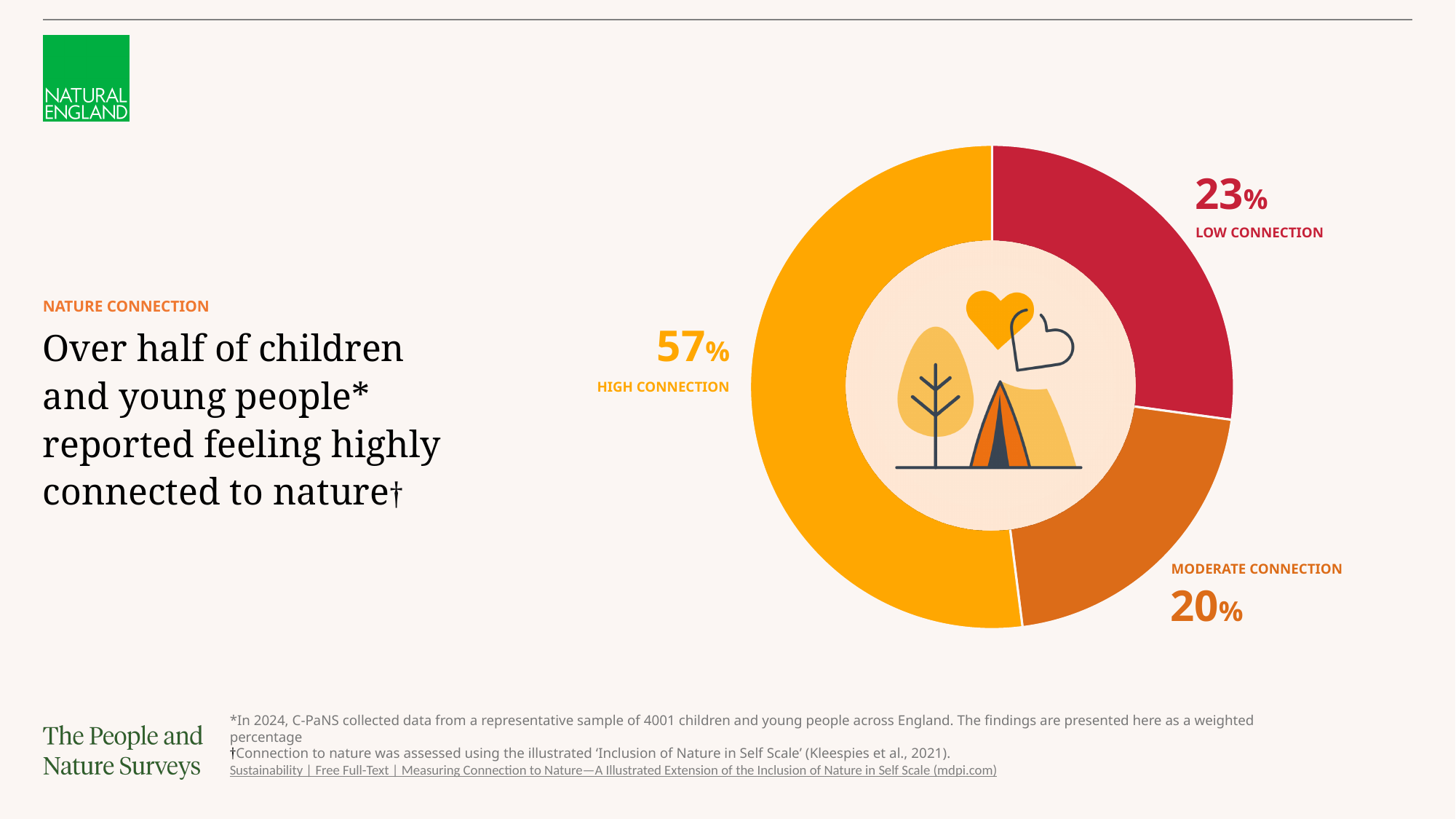
What percentage of children and young people reported a low connection to nature? 23% What is the heading above the slide's main statement? NATURE CONNECTION What is the difference in percentage points between low connection and moderate connection? 3 What percentage of children and young people reported a high connection to nature? 57% Which is larger, the share for low connection or the share for moderate connection? Low connection Which connection category has the smallest share of the chart? Moderate connection How many categories are shown in the chart? 3 What percentage of children and young people reported a moderate connection to nature? 20% What is the difference in percentage points between high connection and low connection? 34 What colour is the segment for low connection? Red What kind of chart is shown on the slide? Doughnut chart Which connection category has the largest share of the chart? High connection